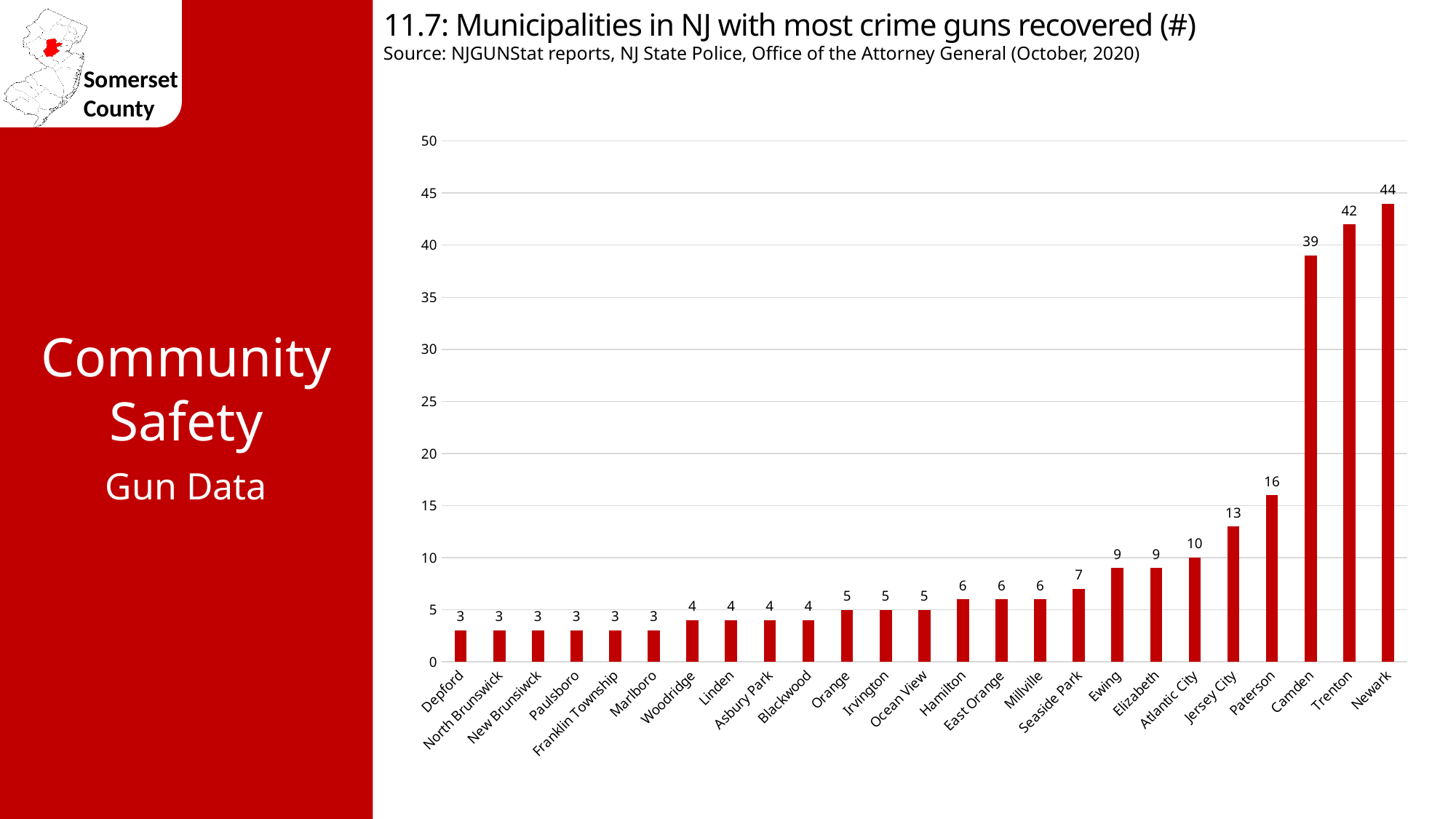
What is the difference in crime guns recovered between Paterson and Atlantic City? 6 Do the values generally rise or fall from left to right along the x axis? Rise What is the number of crime guns recovered in Camden? 39 How many municipalities are shown in the chart? 25 Which municipality has the most crime guns recovered? Newark What kind of chart is shown on the slide? Bar chart What is the number of crime guns recovered in Newark? 44 Is the value for Trenton greater or less than 40? greater Which has more crime guns recovered, Camden or Paterson? Camden What is the number of crime guns recovered in Franklin Township? 3 What is the difference in crime guns recovered between Newark and Trenton? 2 What is the number of crime guns recovered in Jersey City? 13